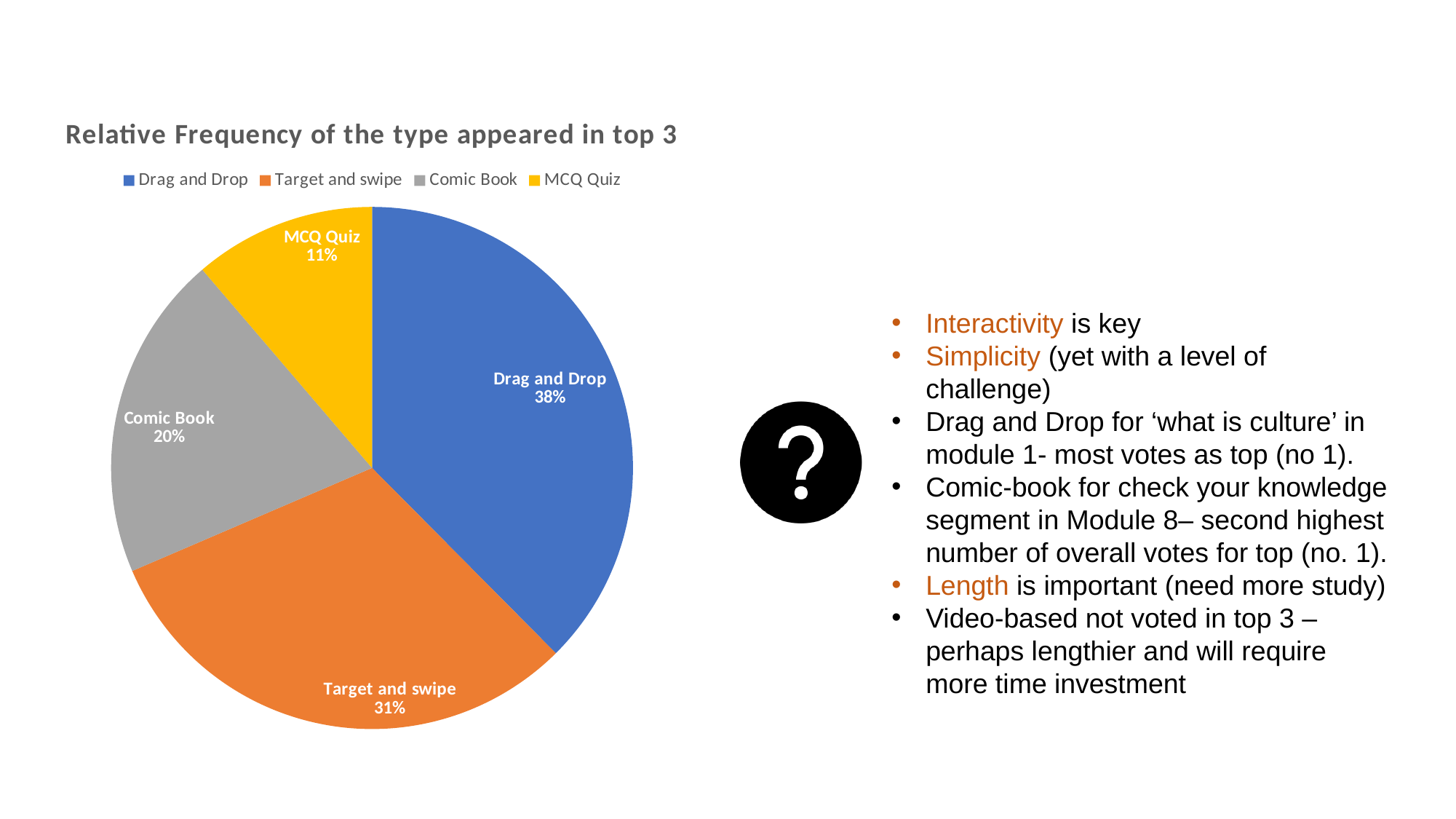
Which category has the largest slice of the pie? Drag and Drop What is the title of the chart? Relative Frequency of the type appeared in top 3 Which is larger, the share for Target and swipe or the share for Comic Book? Target and swipe What type of chart is shown on the slide? Pie chart Which category has the smallest slice of the pie? MCQ Quiz What share of the pie does Comic Book have? 20% How many categories are shown in the pie chart? 4 What share of the pie does Target and swipe have? 31% What share of the pie does MCQ Quiz have? 11% What colour is the Comic Book slice? Grey What is the difference in percentage points between Drag and Drop and Comic Book? 18